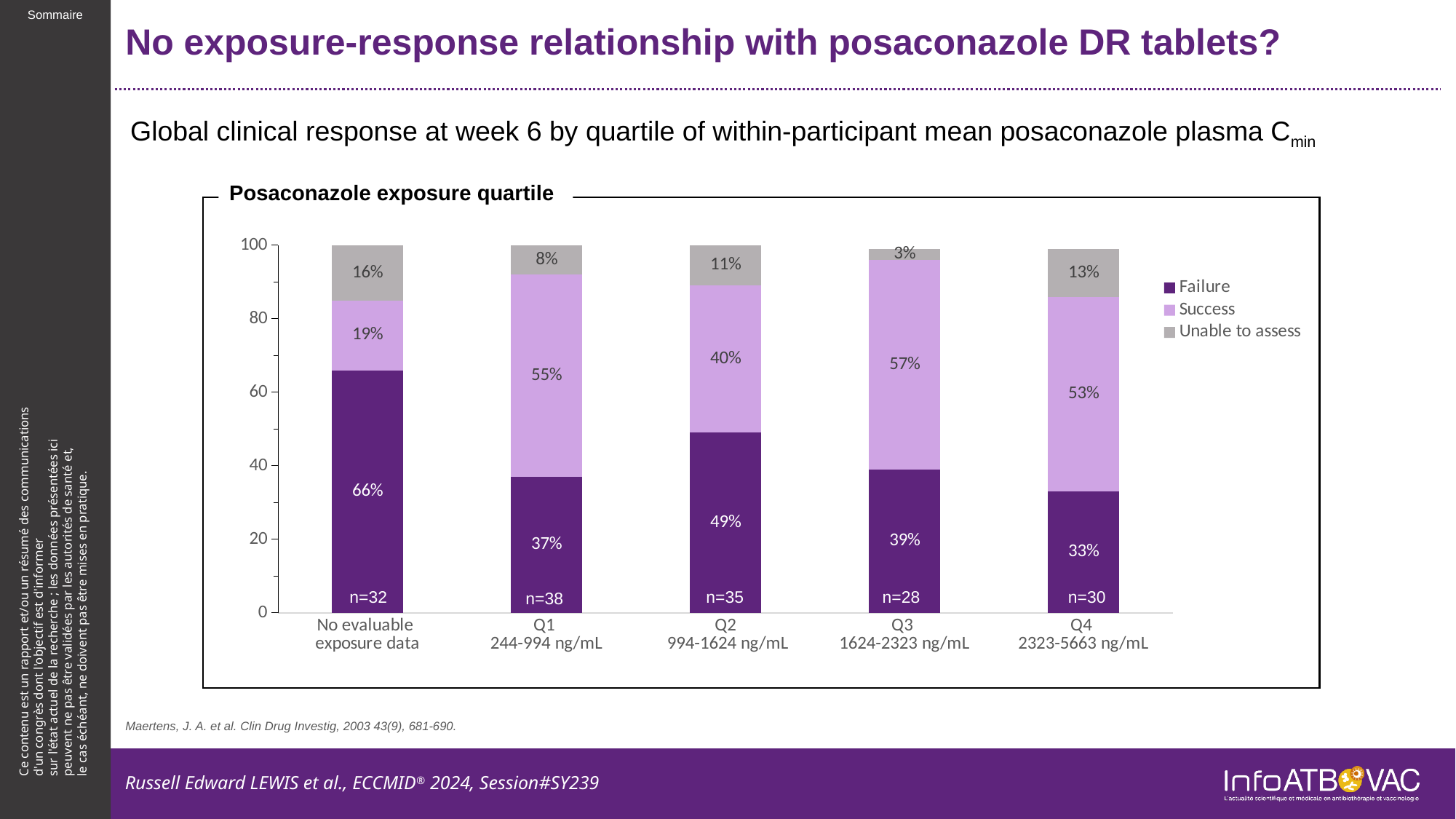
How many series does the legend list? 3 Which is larger, the Failure percentage for Q3 or the Failure percentage for Q4? Q3 What kind of chart is shown on the slide? Stacked bar chart How many categories are shown on the x axis? 5 What is the sample size (n) shown for Q1 (244-994 ng/mL)? n=38 What is the Failure percentage for Q2 (994-1624 ng/mL)? 49% What is the Unable to assess percentage for the 'No evaluable exposure data' group? 16% What is the Success percentage for Q3 (1624-2323 ng/mL)? 57% What is the difference between the Success percentage for Q1 and the Success percentage for Q2? 15% What is the title shown above the chart? Posaconazole exposure quartile Which category has the highest Failure percentage? No evaluable exposure data Which category has the lowest Unable to assess percentage? Q3 (1624-2323 ng/mL)